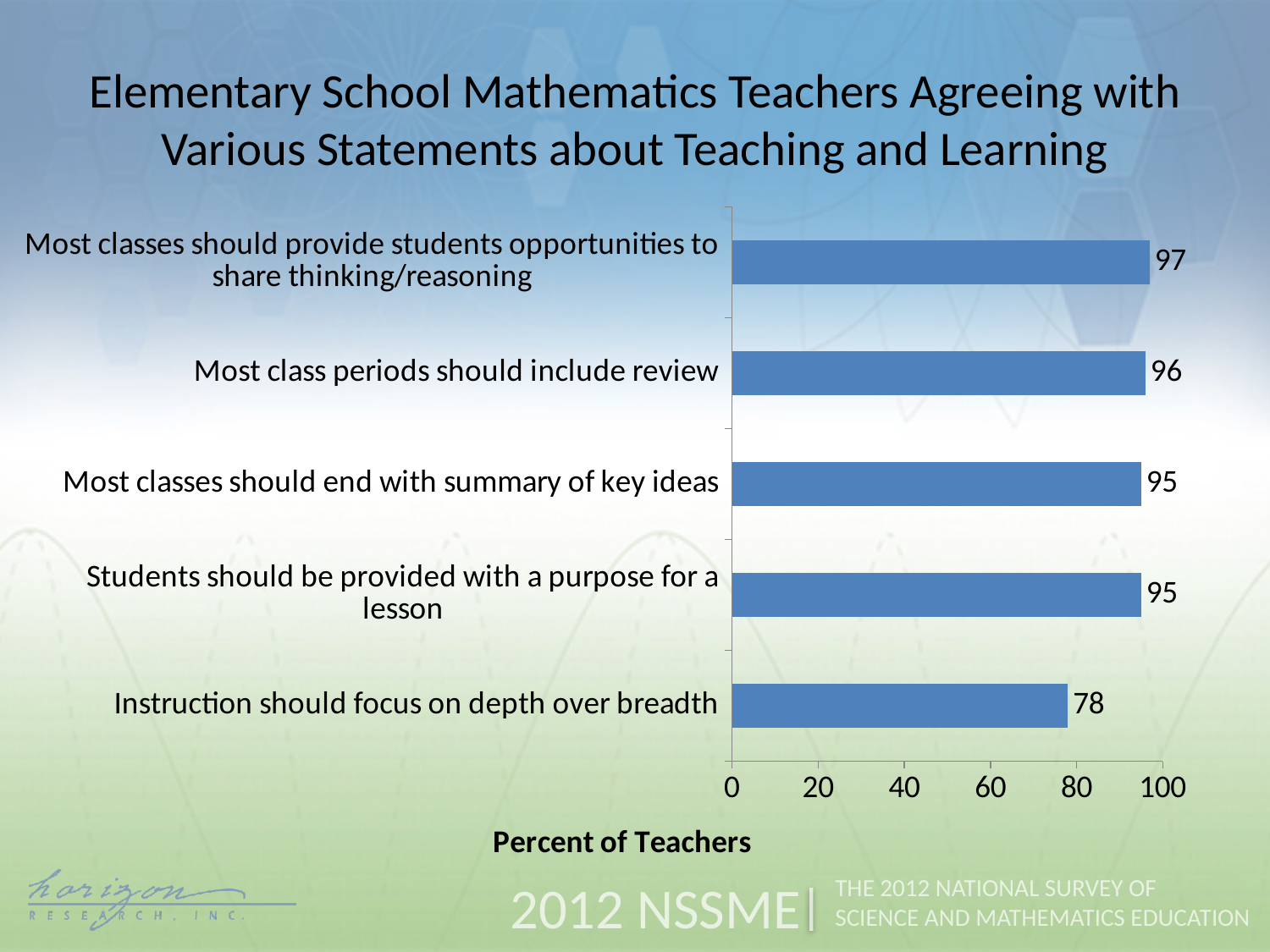
What is the difference in percent of teachers between 'Most class periods should include review' and 'Instruction should focus on depth over breadth'? 18 What kind of chart is shown on the slide? Bar chart Which statement has the lowest percent of teachers agreeing? Instruction should focus on depth over breadth Is the value for 'Instruction should focus on depth over breadth' greater or less than 80? less Which statement has the highest percent of teachers agreeing? Most classes should provide students opportunities to share thinking/reasoning What percent of teachers agree that most class periods should include review? 96 How many statements are shown in the chart? 5 Which has a higher percent of teachers agreeing: 'Most classes should end with summary of key ideas' or 'Instruction should focus on depth over breadth'? Most classes should end with summary of key ideas What percent of teachers agree that most classes should provide students opportunities to share thinking/reasoning? 97 What percent of teachers agree that instruction should focus on depth over breadth? 78 What is the label of the horizontal axis? Percent of Teachers What is the difference in percent of teachers between 'Most classes should provide students opportunities to share thinking/reasoning' and 'Students should be provided with a purpose for a lesson'? 2